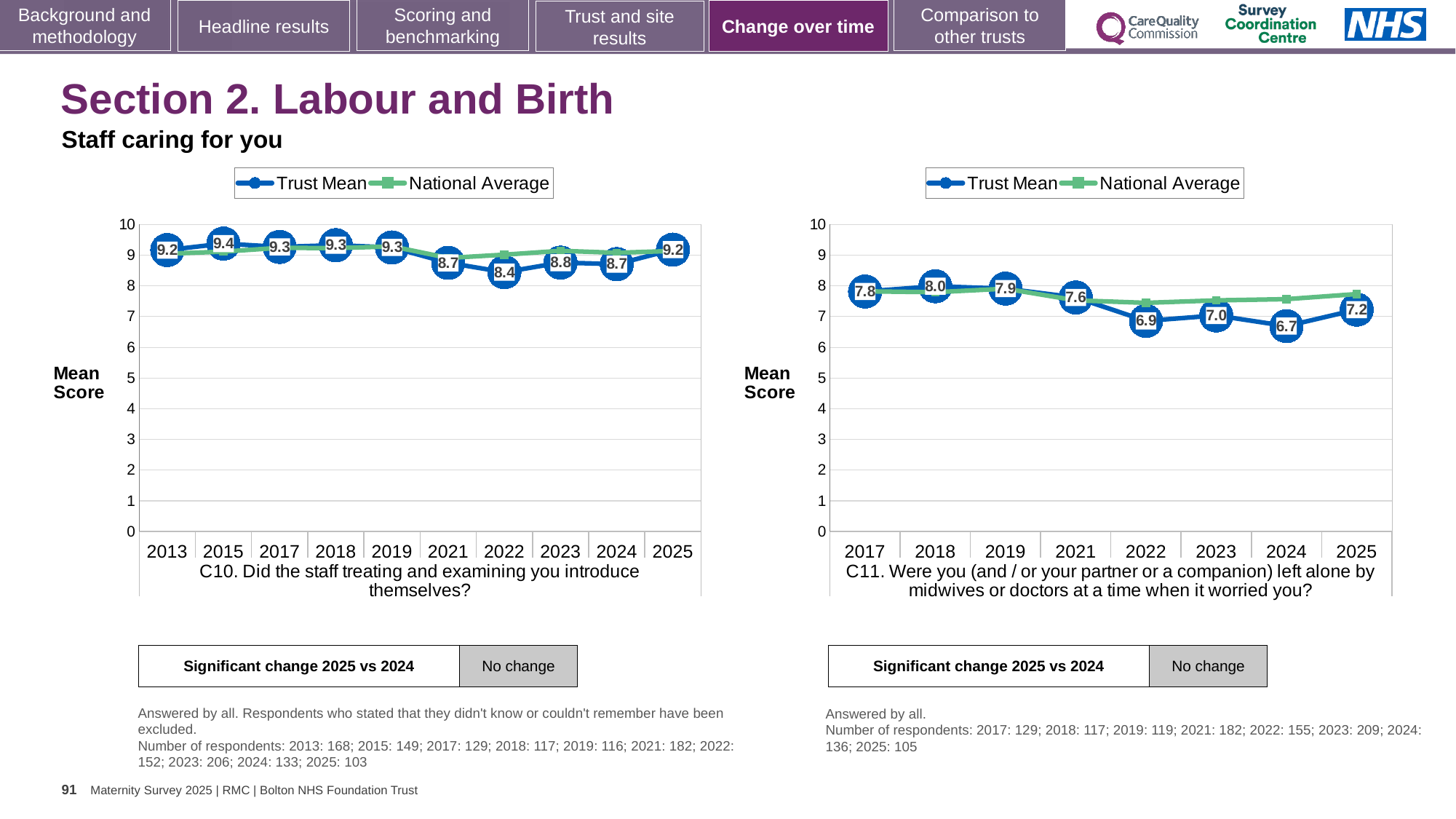
In the C10 chart on the left, which year has the lowest Trust Mean? 2022 How many series does the legend of the C10 chart on the left list? 2 In the C10 chart on the left, what is the difference between the Trust Mean for 2015 and for 2022? 1.0 In the C11 chart on the right, which year has the highest Trust Mean? 2018 In the C10 chart on the left, what is the Trust Mean for 2022? 8.4 In the C11 chart on the right, which year has the lowest Trust Mean? 2024 In the C11 chart on the right, is the Trust Mean for 2019 larger or smaller than the Trust Mean for 2022? larger In the C11 chart on the right, what is the Trust Mean for 2024? 6.7 In the C11 chart on the right, is the National Average for 2025 greater or less than 7? greater In the C10 chart on the left, which year has the highest Trust Mean? 2015 In the C10 chart on the left, what is the Trust Mean for 2025? 9.2 How many years are shown on the x axis of the C11 chart on the right? 8